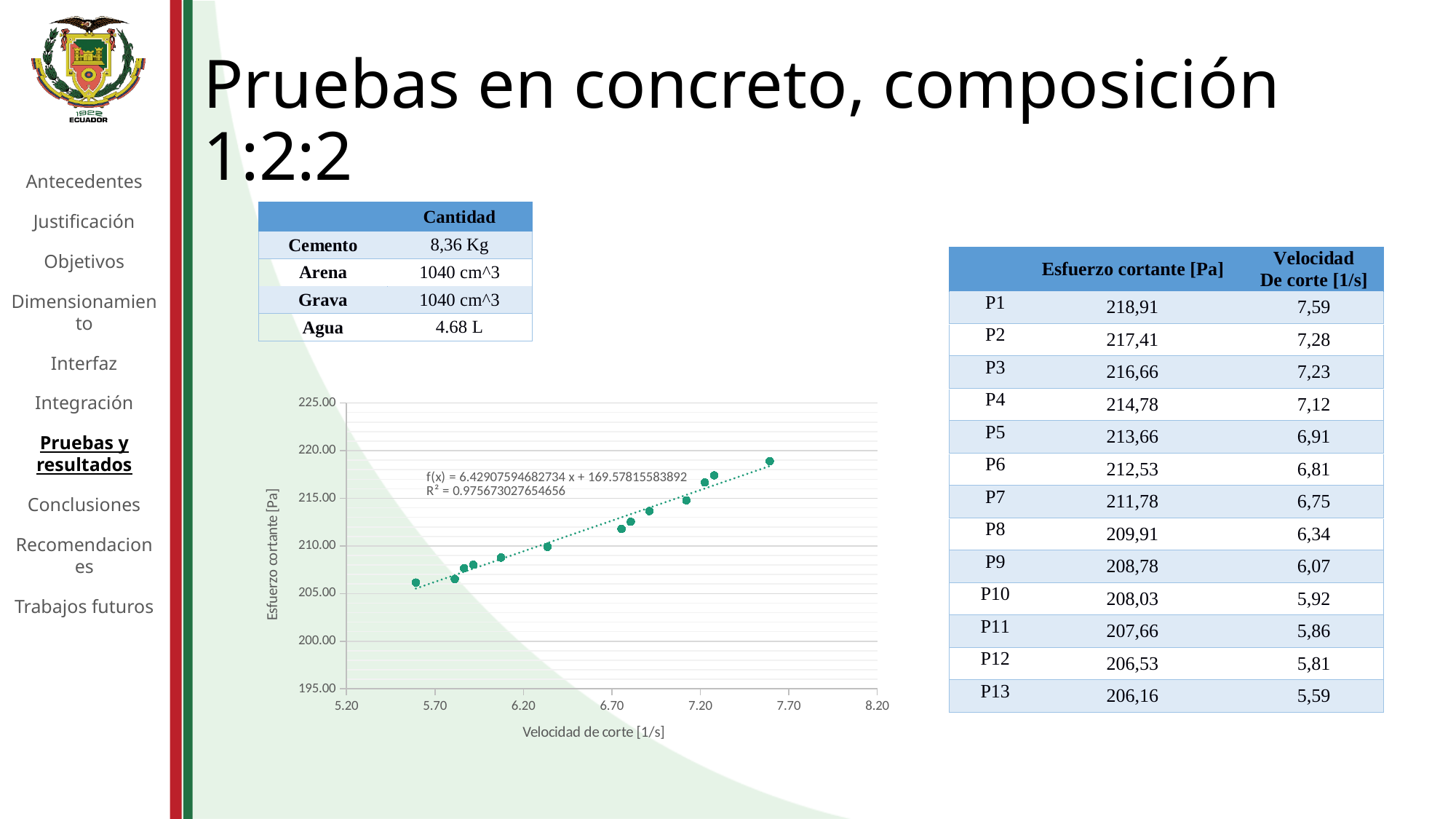
What kind of chart is shown on the slide? scatter chart What is the label of the x axis of the chart? Velocidad de corte [1/s] How many data points are plotted on the chart? 13 Which point has the higher shear stress: the one at the highest shear rate or the one at the lowest shear rate? the one at the highest shear rate Do the plotted values rise or fall as the shear rate (Velocidad de corte) increases along the x axis? rise What is the label of the y axis of the chart? Esfuerzo cortante [Pa] Is the shear stress value of the point at the lowest shear rate greater or less than 210? less Is the shear stress value of the point at the highest shear rate greater or less than 215? greater Are all plotted points on the chart above 200 on the y axis? yes What is the maximum value shown on the y axis of the chart? 225.00